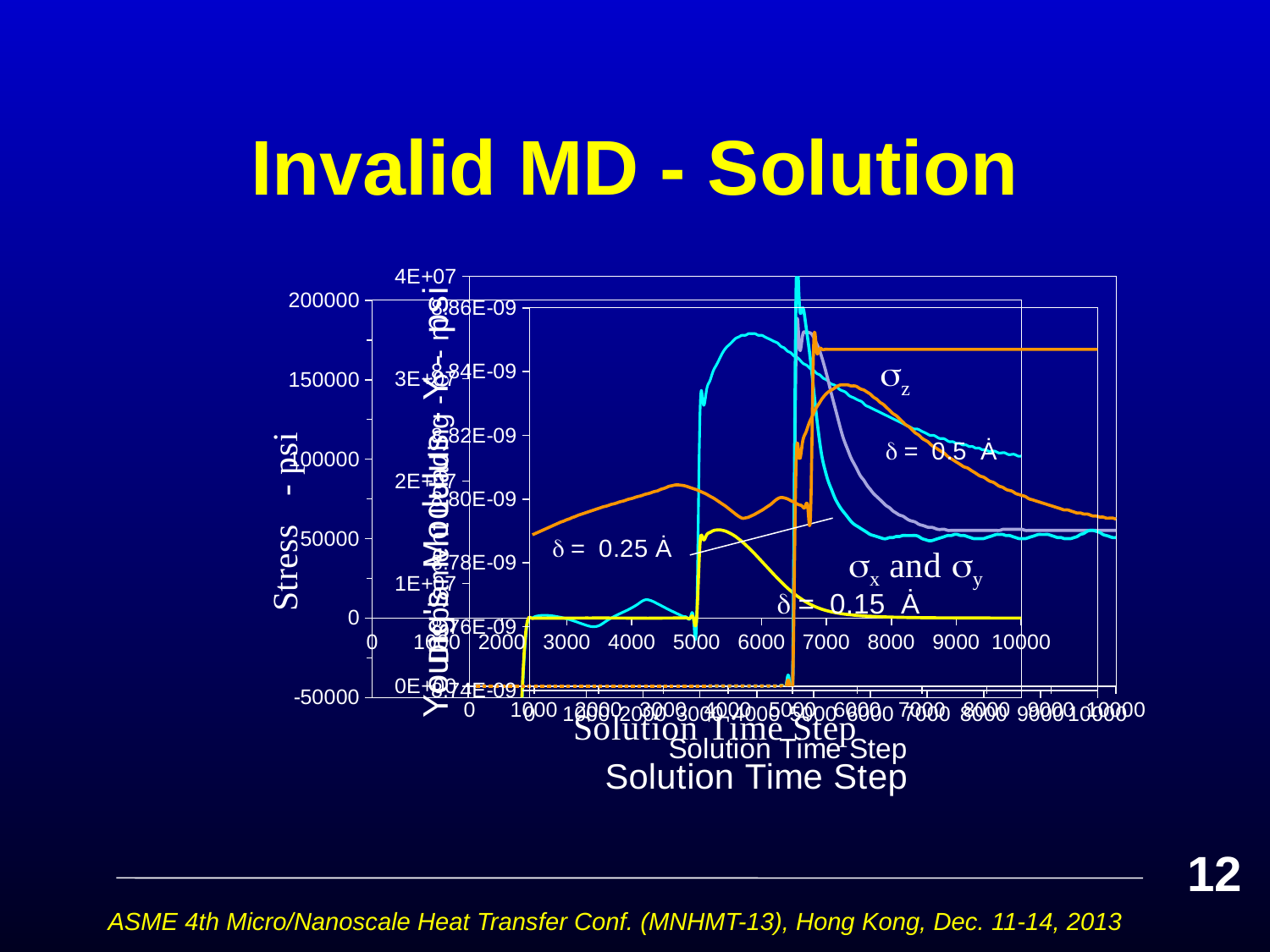
What is the smallest δ value annotated on the charts? 0.15 Å What is the largest δ value annotated on the charts? 0.5 Å What kind of chart is used on this slide to plot stress against solution time step? Line chart How many different δ values are annotated on the charts? 3 Which stress component is labelled on the curve that peaks near 150000 psi around time step 7000? σz On the Young's Modulus chart, what is the highest value shown on the y axis? 4E+07 On the stress chart, what is the highest value shown on the y axis? 200000 What is the largest value shown on the x axis of the stress chart? 10000 What is the y-axis label of the outermost chart, whose axis runs from -50000 to 200000? Stress - psi On the stress chart, what is the lowest value shown on the y axis? -50000 What is the label of the x axis shared by the charts on this slide? Solution Time Step Which stress components are labelled together on the lower curves of the stress chart? σx and σy